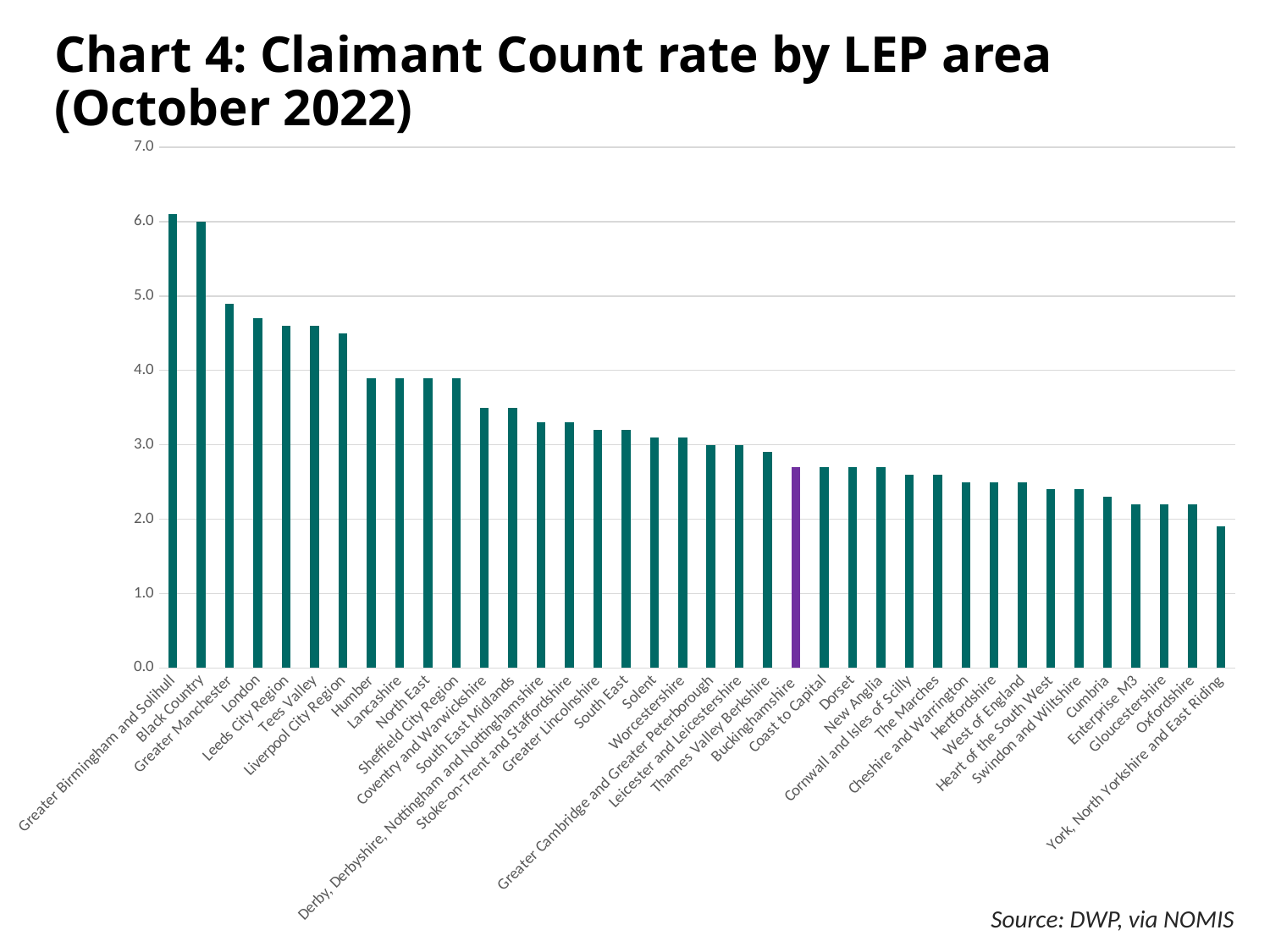
Which LEP area has the highest Claimant Count rate? Greater Birmingham and Solihull Is the value for Buckinghamshire greater or less than 3.0? less Which has the higher Claimant Count rate, Oxfordshire or Tees Valley? Tees Valley What kind of chart is shown on the slide? Bar chart Which LEP area's bar is shown in a different colour (purple) from the rest? Buckinghamshire Which LEP area has the lowest Claimant Count rate? York, North Yorkshire and East Riding Is the value for London greater or less than 4.0? greater Is the value for Cumbria greater or less than 3.0? less Which has the higher Claimant Count rate, Greater Manchester or Humber? Greater Manchester How many LEP areas are plotted on the chart? 38 Do the values rise or fall moving from left to right along the x axis? Fall